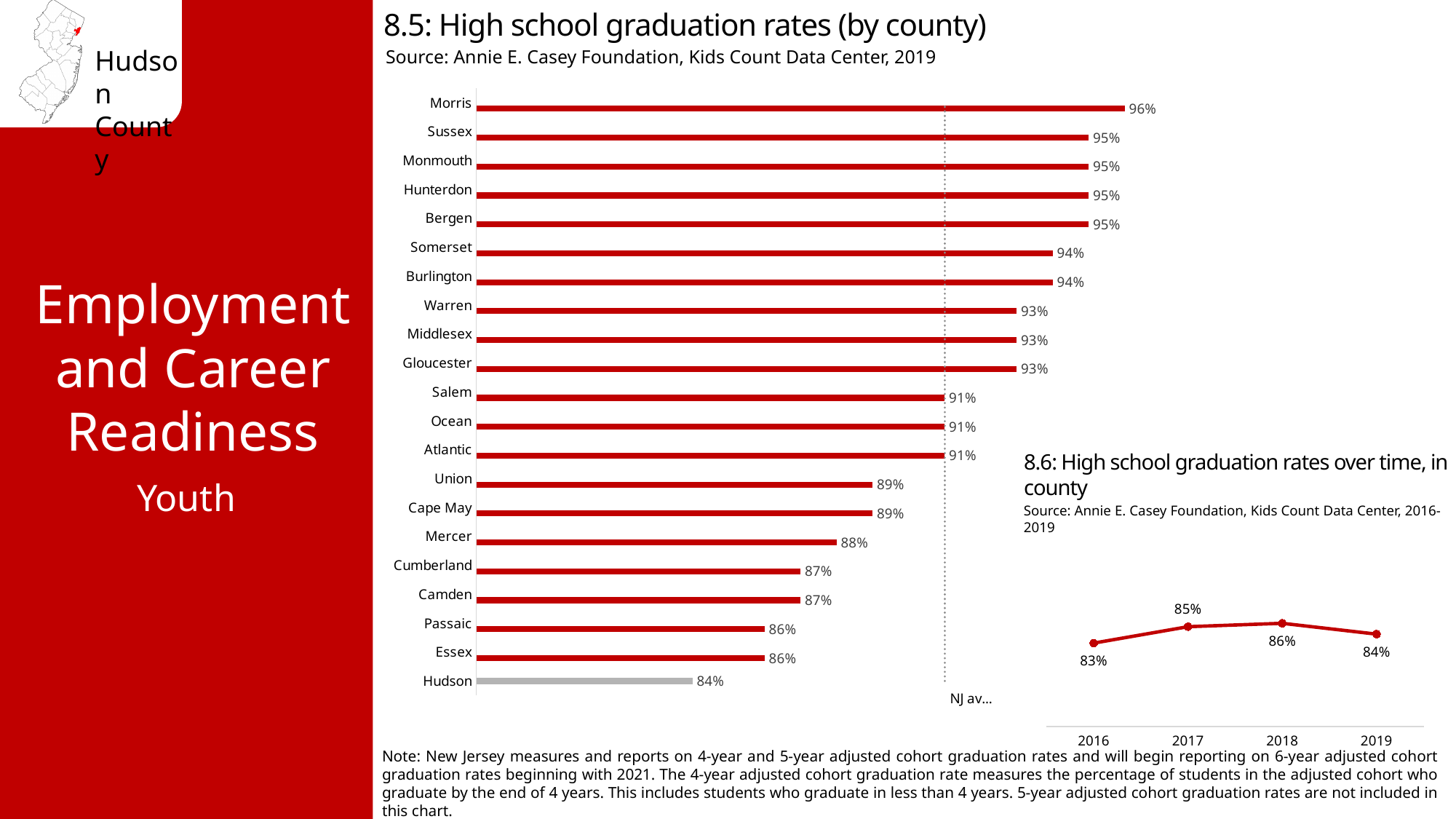
What kind of chart is '8.5: High school graduation rates (by county)'? Bar chart In the chart '8.6: High school graduation rates over time, in county', what is the graduation rate for 2017? 85% In the chart '8.6: High school graduation rates over time, in county', which year has the highest graduation rate? 2018 In the chart '8.6: High school graduation rates over time, in county', what is the difference between the 2018 and 2016 graduation rates? 3% In the chart '8.5: High school graduation rates (by county)', which county has the lowest graduation rate? Hudson In the chart '8.5: High school graduation rates (by county)', what is the graduation rate for Hudson? 84% In the chart '8.5: High school graduation rates (by county)', what is the graduation rate for Morris? 96% In the chart '8.5: High school graduation rates (by county)', how many counties are shown? 21 In the chart '8.5: High school graduation rates (by county)', what is the difference between the graduation rates of Morris and Hudson? 12% In the chart '8.5: High school graduation rates (by county)', which county has a higher graduation rate, Mercer or Camden? Mercer What kind of chart is '8.6: High school graduation rates over time, in county'? Line chart In the chart '8.5: High school graduation rates (by county)', which county has the highest graduation rate? Morris